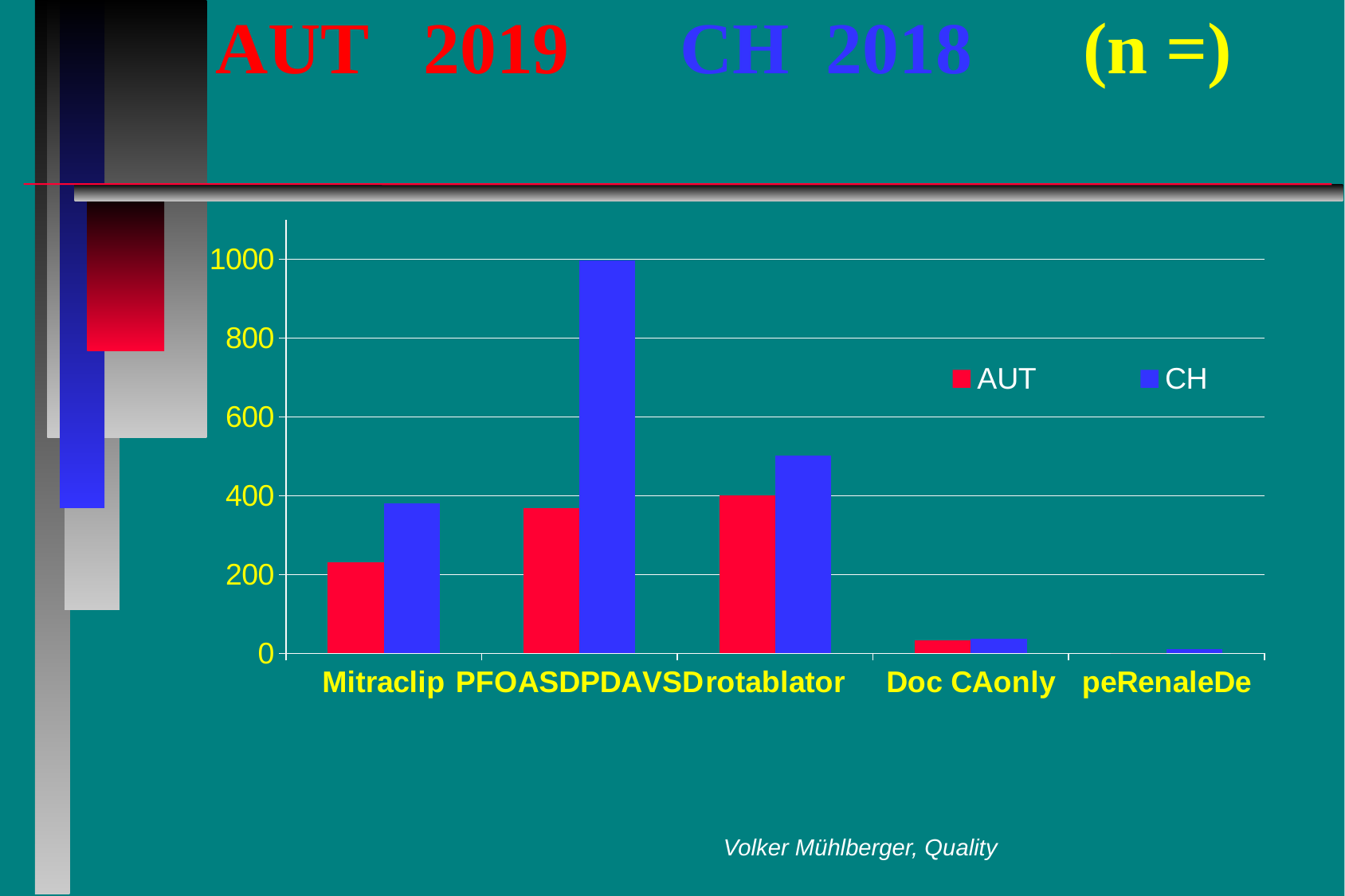
Which category has the lowest AUT value? peRenaleDe Is the CH value for PFOASDPDAVSD greater or less than 800? greater For PFOASDPDAVSD, which series has the larger value, AUT or CH? CH For Mitraclip, which series has the larger value, AUT or CH? CH Which colour represents the AUT series in the chart's legend? red Is the AUT value for Mitraclip greater or less than 400? less How many categories are shown on the x axis of the chart? 5 How many series does the chart's legend list? 2 Which category has the highest CH value? PFOASDPDAVSD Which category has the lowest CH value? peRenaleDe What kind of chart is shown on the slide? bar chart Is the CH value for rotablator greater or less than 400? greater